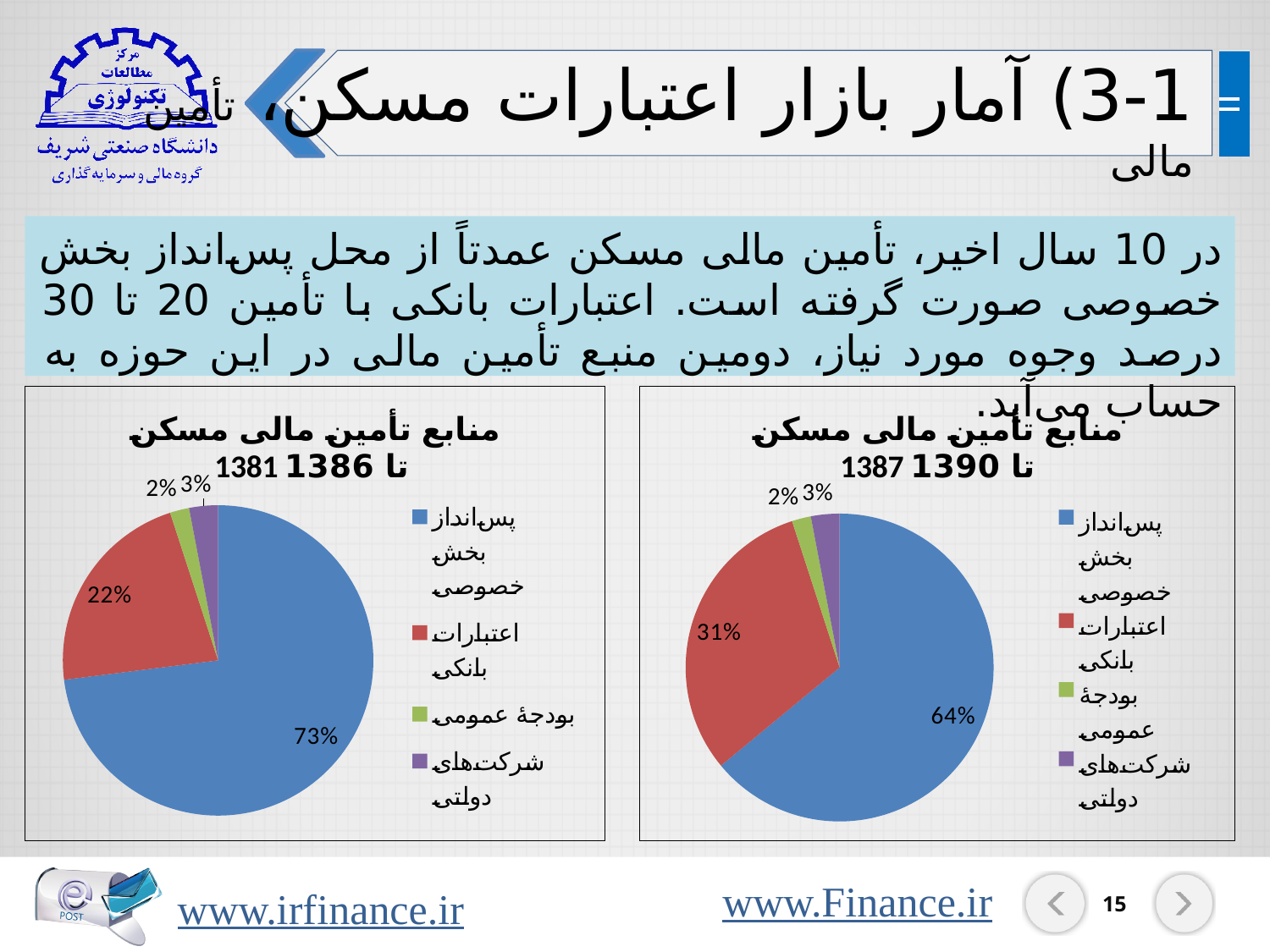
What is the difference between the share of پس‌انداز بخش خصوصی in the left chart (1381 to 1386) and in the right chart (1387 to 1390)? 9% How many slices does the left pie chart (1381 to 1386) have? 4 In the right pie chart (1387 to 1390), what colour is the slice for اعتبارات بانکی? red In the left pie chart (1381 to 1386), which source has the smallest share? بودجۀ عمومی In the right pie chart (1387 to 1390), what is the difference between the shares of پس‌انداز بخش خصوصی and اعتبارات بانکی? 33% In the left pie chart (1381 to 1386), what share does اعتبارات بانکی (bank credit) have? 22% What type of chart is used on the right side of the slide (1387 to 1390)? pie chart In the right pie chart (1387 to 1390), what share does پس‌انداز بخش خصوصی (private sector savings) have? 64% Is the share of اعتبارات بانکی larger in the left chart (1381 to 1386) or in the right chart (1387 to 1390)? right chart (1387 to 1390) In the right pie chart (1387 to 1390), what share does اعتبارات بانکی (bank credit) have? 31% In the left pie chart (1381 to 1386), what share does پس‌انداز بخش خصوصی (private sector savings) have? 73% In the right pie chart (1387 to 1390), which source has the largest share? پس‌انداز بخش خصوصی